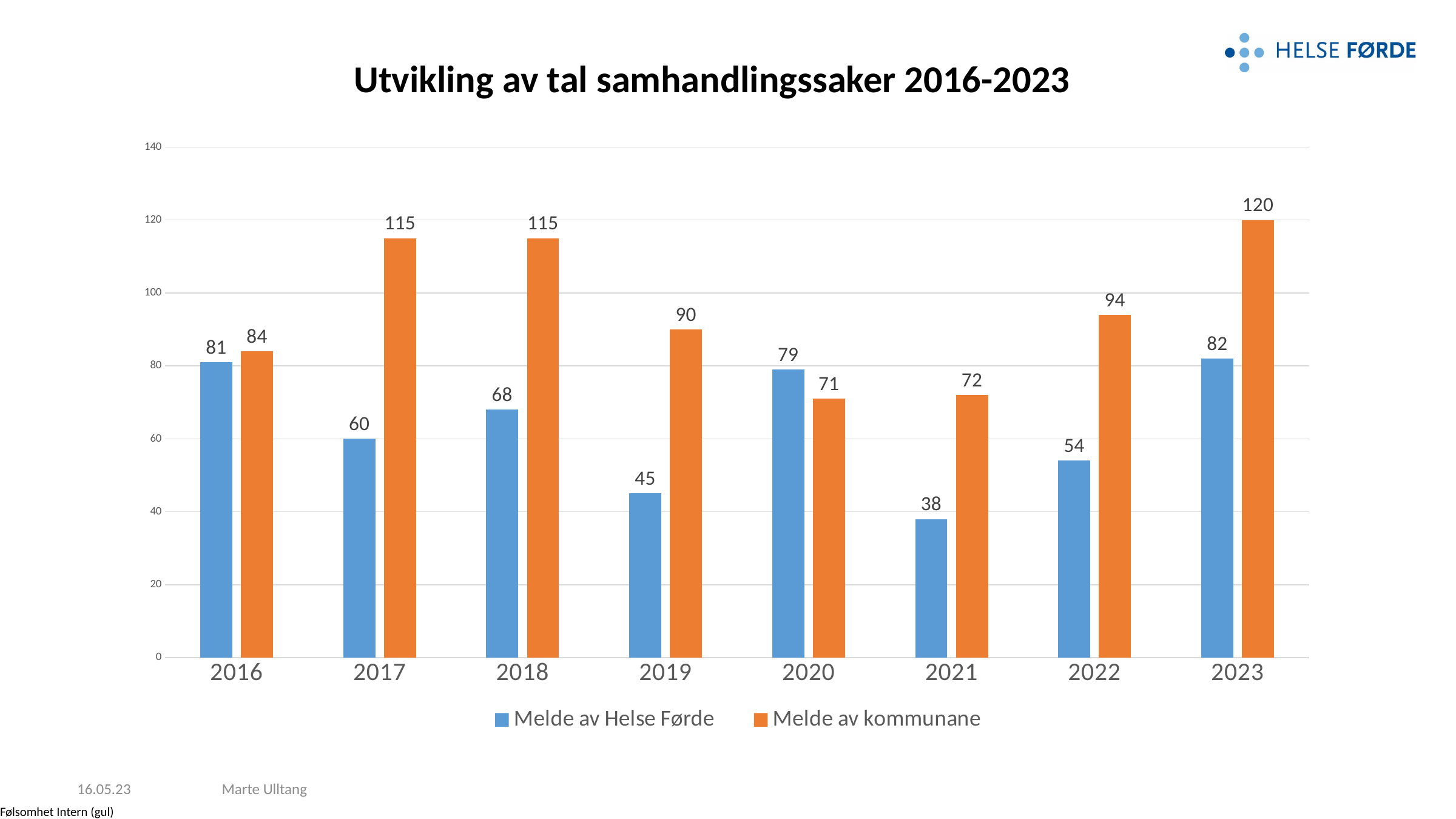
Is the value for 'Melde av kommunane' in 2017 greater or less than 100? greater What is the value for 'Melde av kommunane' in 2022? 94 How many series does the legend list? 2 How many years are shown on the x axis? 8 Which year has the highest value for 'Melde av kommunane'? 2023 What is the value for 'Melde av Helse Førde' in 2019? 45 What colour are the bars for 'Melde av kommunane'? Orange What kind of chart is shown on the slide? Bar chart What is the difference between 'Melde av kommunane' and 'Melde av Helse Førde' in 2021? 34 In 2020, which series has the larger value, 'Melde av Helse Førde' or 'Melde av kommunane'? Melde av Helse Førde What is the title of the chart? Utvikling av tal samhandlingssaker 2016-2023 Which year has the lowest value for 'Melde av Helse Førde'? 2021